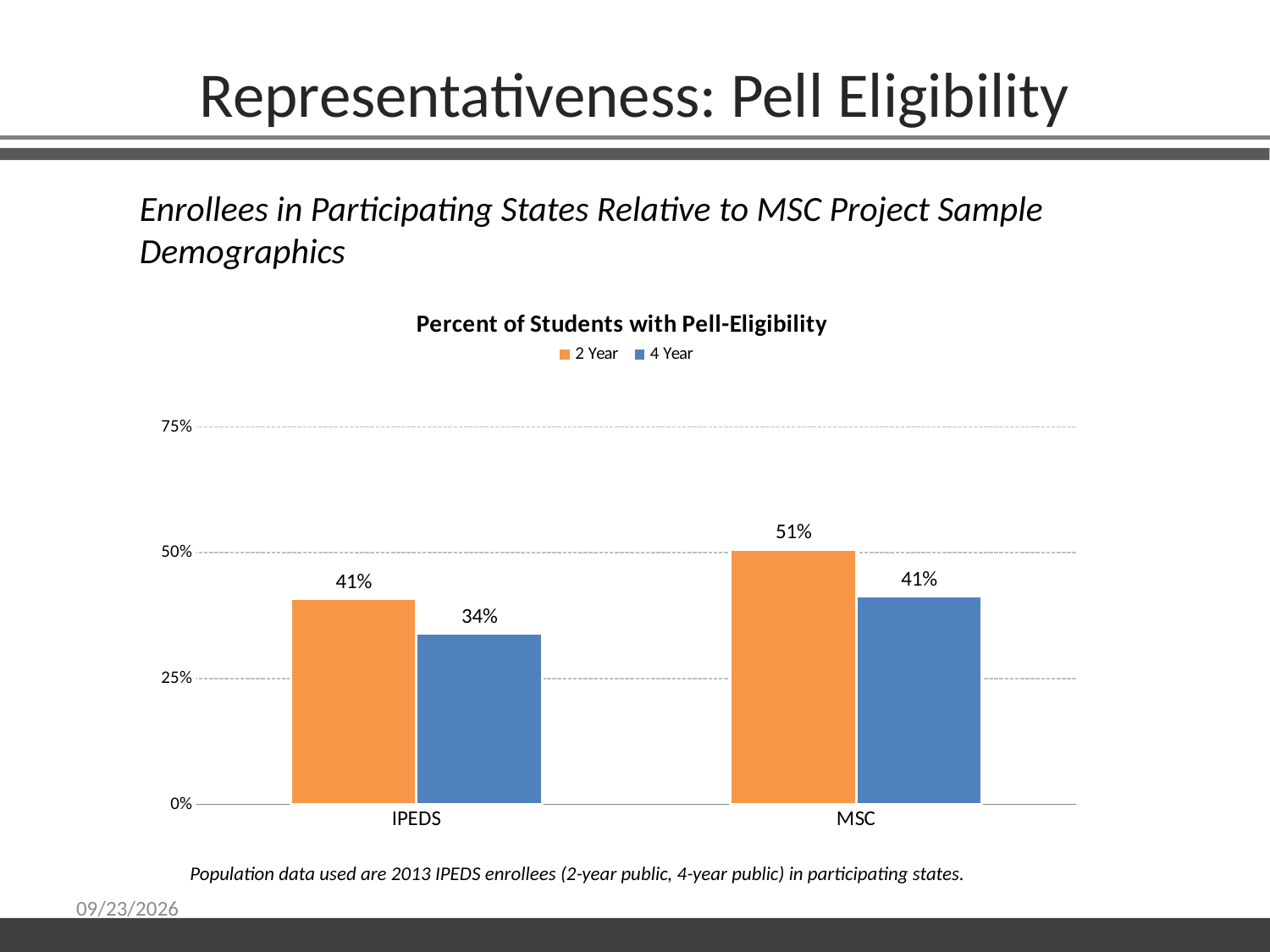
What is the value for 2 Year at IPEDS? 41% What kind of chart is shown? Bar chart Which category has the lowest 4 Year value? IPEDS What is the value for 4 Year at IPEDS? 34% What is the value for 2 Year at MSC? 51% How many categories are shown on the x axis? 2 What is the value for 4 Year at MSC? 41% Which is larger, the 4 Year value at IPEDS or the 4 Year value at MSC? MSC Which category has the highest 2 Year value? MSC What is the difference between the 2 Year and 4 Year values at MSC? 10% What is the difference between the 2 Year values for MSC and IPEDS? 10% How many series does the legend list? 2